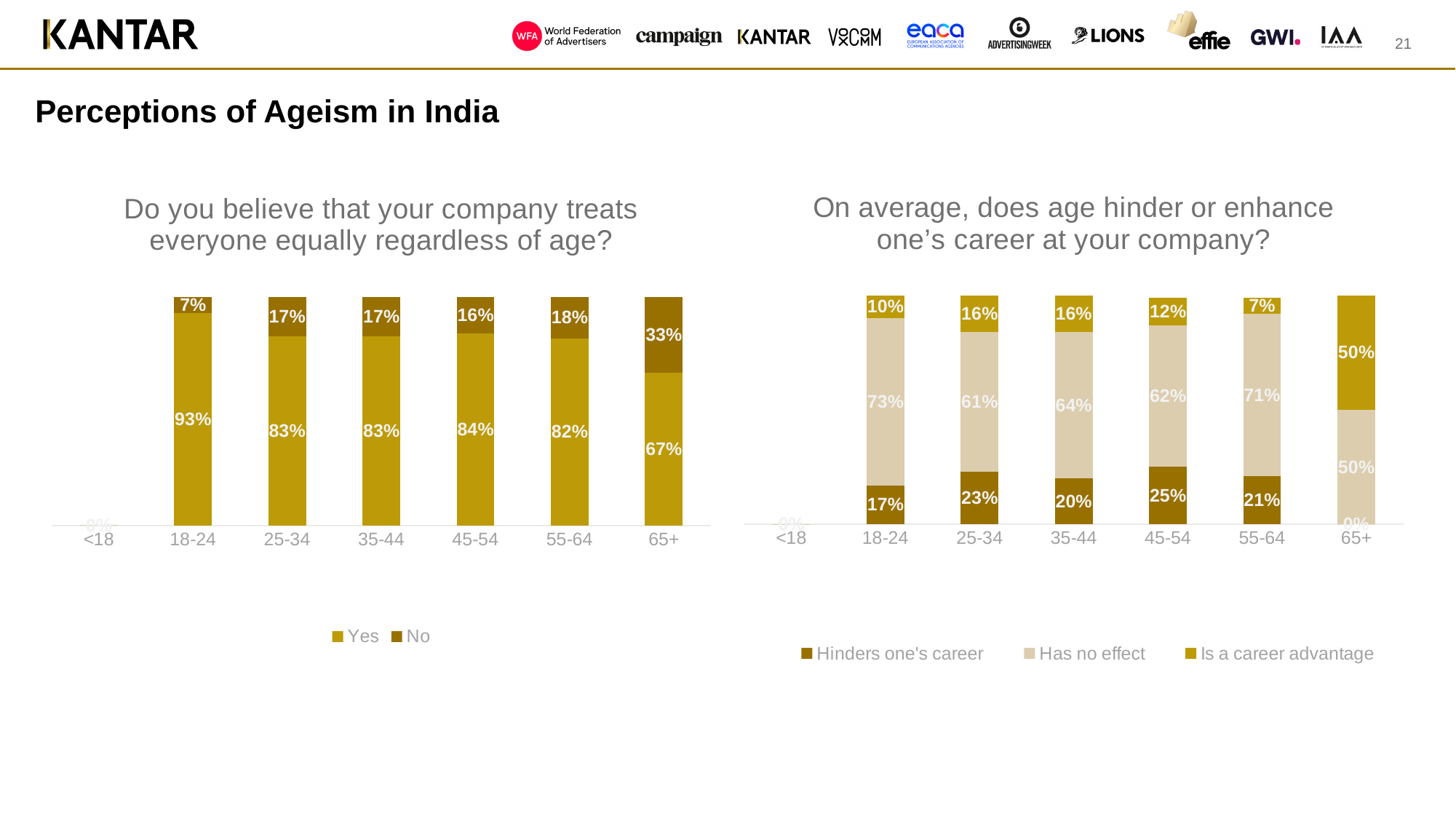
In the chart 'Do you believe that your company treats everyone equally regardless of age?', what is the 'No' value for the 65+ age group? 33% In the chart 'Do you believe that your company treats everyone equally regardless of age?', what is the 'Yes' value for the 18-24 age group? 93% In the chart 'Do you believe that your company treats everyone equally regardless of age?', which age group has the lowest 'No' value among groups with a non-zero bar? 18-24 In the chart 'On average, does age hinder or enhance one's career at your company?', how many series does the legend list? 3 In the chart 'On average, does age hinder or enhance one's career at your company?', which age group has the highest 'Is a career advantage' value? 65+ In the chart 'On average, does age hinder or enhance one's career at your company?', what is the 'Has no effect' value for the 18-24 age group? 73% In the chart 'Do you believe that your company treats everyone equally regardless of age?', how many series does the legend list? 2 What type of chart is used in the chart 'On average, does age hinder or enhance one's career at your company?'? Stacked bar chart In the chart 'Do you believe that your company treats everyone equally regardless of age?', which age group has the highest 'No' value? 65+ In the chart 'Do you believe that your company treats everyone equally regardless of age?', what is the difference between the 'Yes' values for 18-24 and 65+? 26 percentage points In the chart 'On average, does age hinder or enhance one's career at your company?', what is the 'Hinders one's career' value for the 45-54 age group? 25% In the chart 'On average, does age hinder or enhance one's career at your company?', is the 'Has no effect' value larger for 55-64 or for 25-34? 55-64